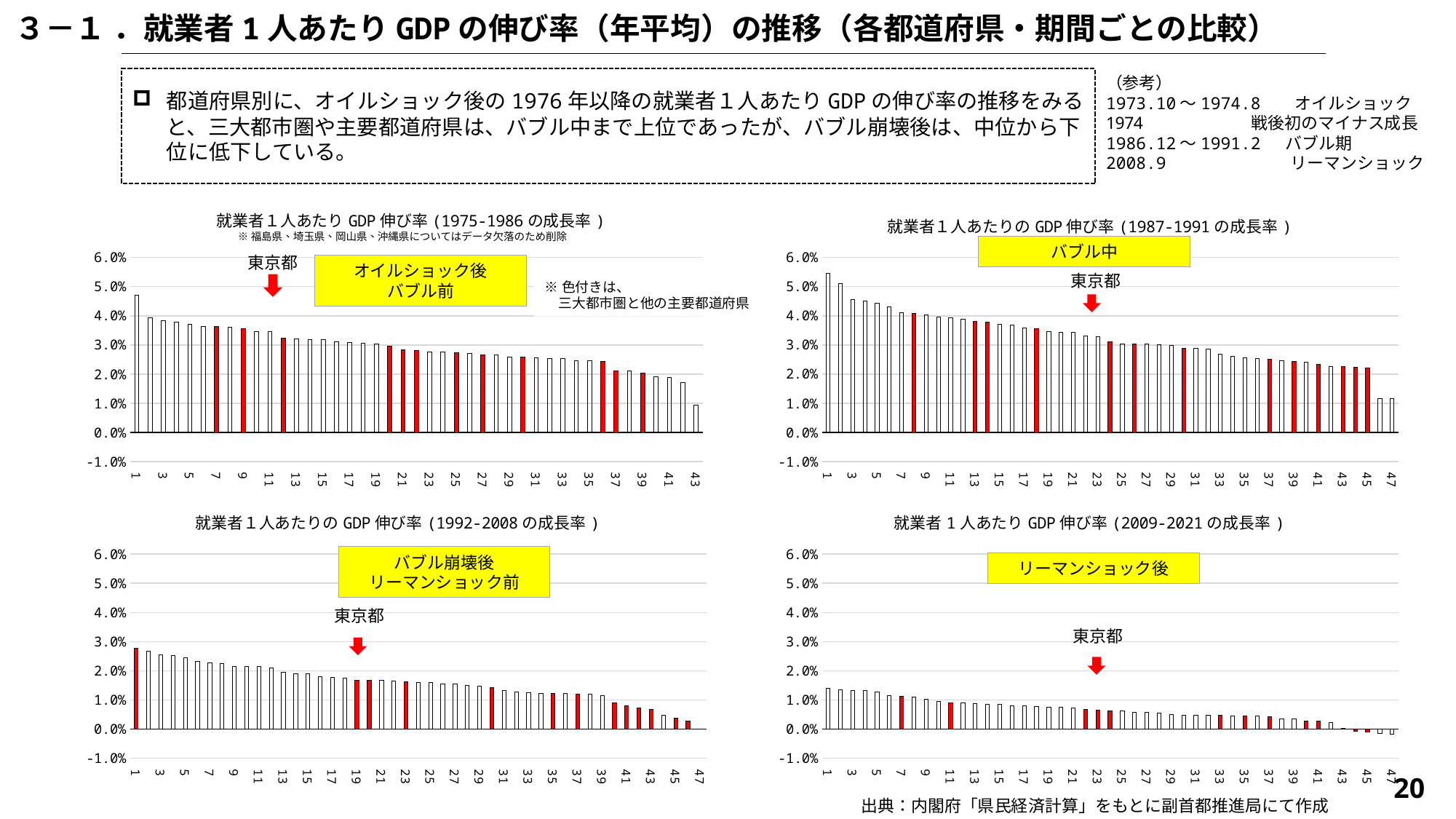
In the top-left chart (1975-1986 の成長率), do the bar values rise or fall from left to right along the x axis? fall How many bars are plotted in the top-right chart (1987-1991 の成長率)? 47 In the bottom-left chart (1992-2008 の成長率), is the value for position 1 greater or less than 2.0%? greater In the top-right chart (1987-1991 の成長率), is the bar marked 東京都 (position 19) greater or less than 3.0%? greater In the top-left chart (1975-1986 の成長率), is the value for position 1 greater or less than 4.0%? greater In the top-left chart (1975-1986 の成長率), which x-axis position has the highest bar? 1 What kind of chart is the top-left chart (1975-1986 の成長率)? bar chart What is the title of the bottom-right chart? 就業者1人あたりGDP伸び率（2009-2021の成長率） How many bars are plotted in the top-left chart (1975-1986 の成長率)? 43 Which chart on the slide carries the yellow label バブル中? the top-right chart (1987-1991 の成長率)